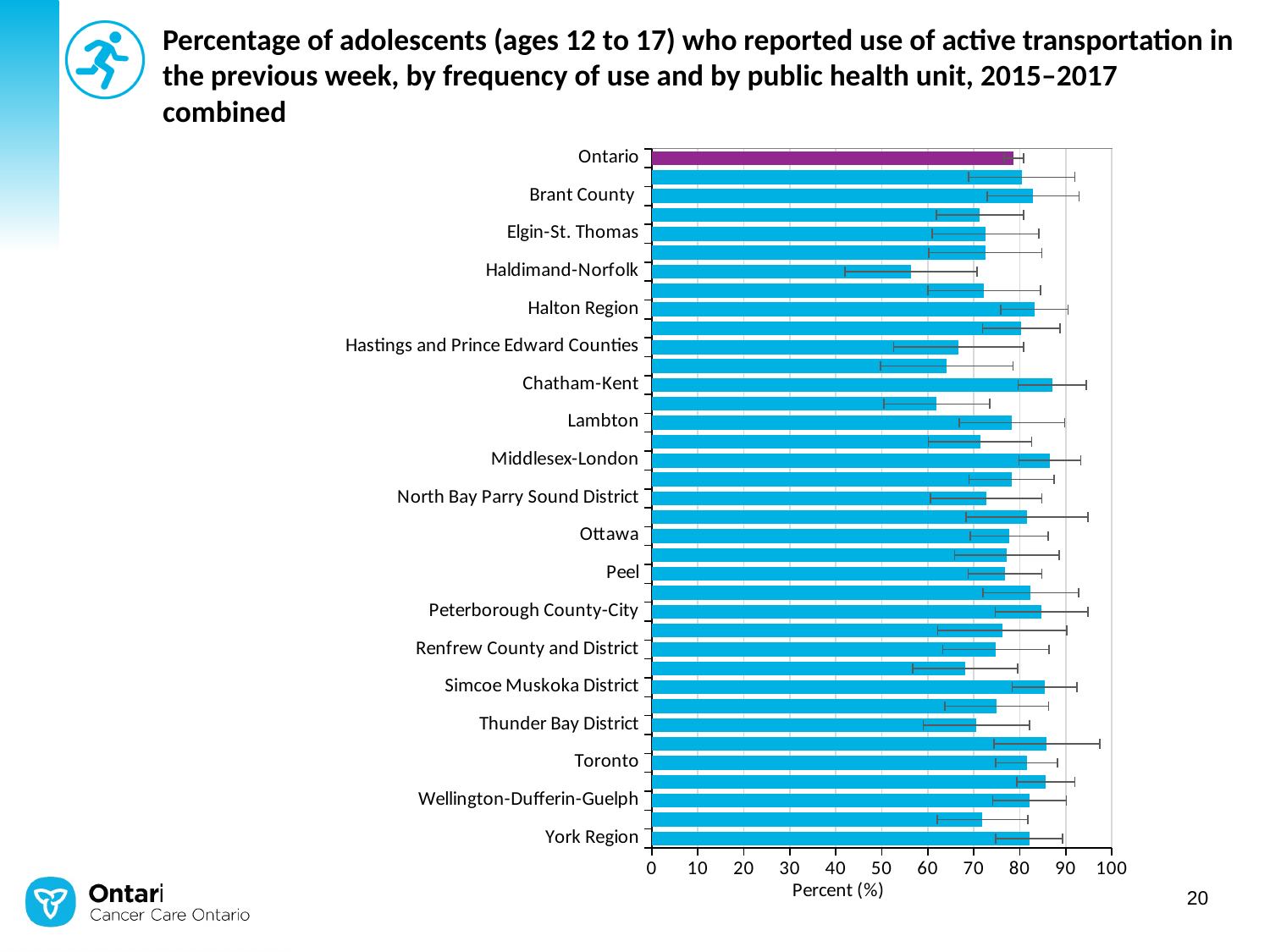
Which has a higher value, Halton Region or Lambton? Halton Region Is the value for Ontario greater or less than 70? greater Is the value for Hastings and Prince Edward Counties greater or less than 70? less Is the value for Thunder Bay District greater or less than 80? less What is the label on the horizontal axis of the chart? Percent (%) Which public health unit has the lowest percentage of adolescents reporting active transportation? Haldimand-Norfolk What kind of chart is shown on the slide? bar chart Which has a higher value, Chatham-Kent or Haldimand-Norfolk? Chatham-Kent Which has a higher value, Toronto or Hastings and Prince Edward Counties? Toronto